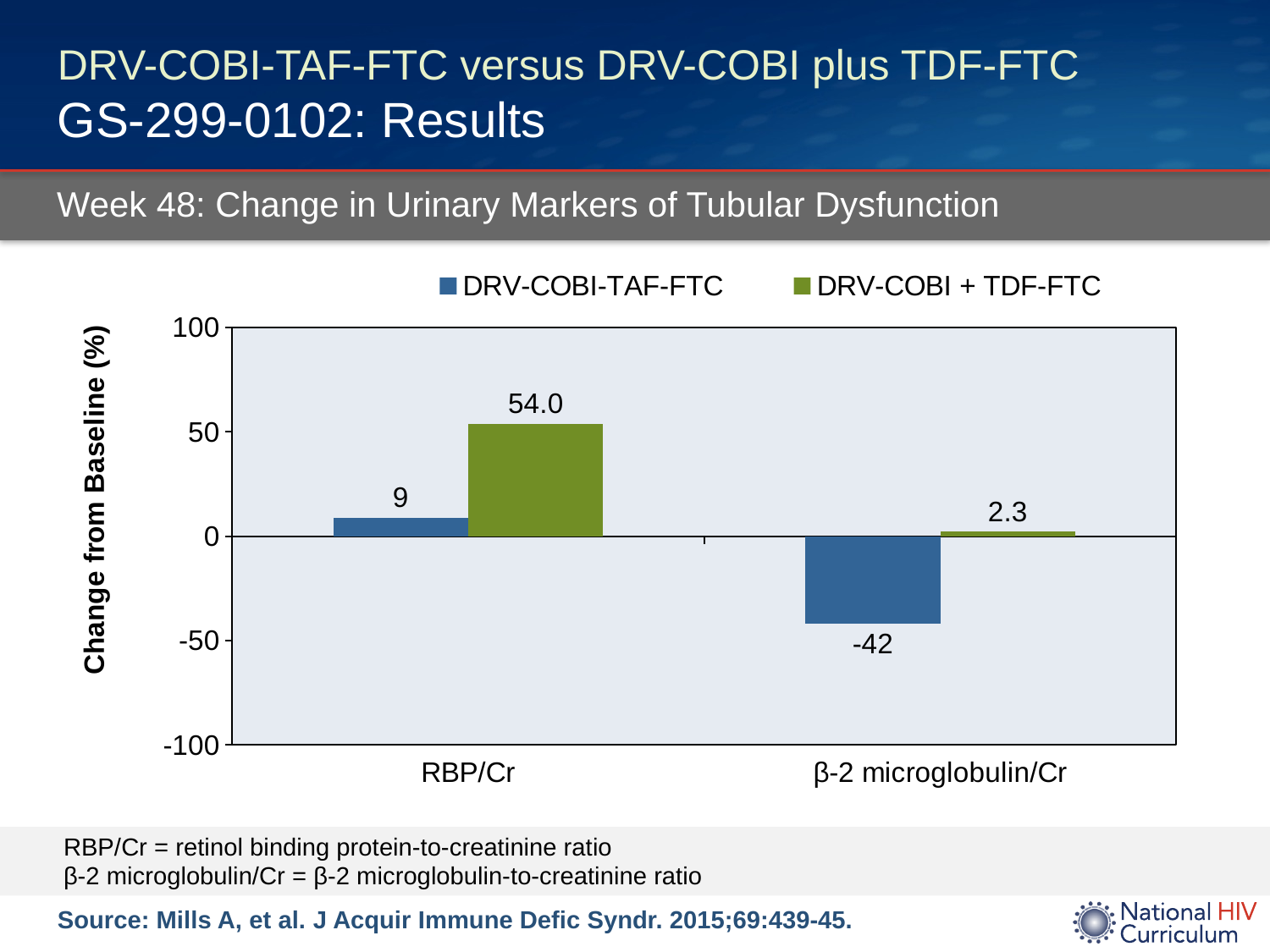
Is the DRV-COBI + TDF-FTC value for RBP/Cr greater or less than 50? greater What is the difference between the DRV-COBI + TDF-FTC and DRV-COBI-TAF-FTC values for RBP/Cr? 45 How many categories are shown on the x axis? 2 What kind of chart is shown on the slide? bar chart Which bar shows the highest change from baseline on the chart? DRV-COBI + TDF-FTC, RBP/Cr What is the change from baseline for DRV-COBI-TAF-FTC in β-2 microglobulin/Cr? -42 Which bar shows the lowest change from baseline on the chart? DRV-COBI-TAF-FTC, β-2 microglobulin/Cr For β-2 microglobulin/Cr, which series has the larger change from baseline? DRV-COBI + TDF-FTC What is the change from baseline for DRV-COBI + TDF-FTC in β-2 microglobulin/Cr? 2.3 How many series does the legend list? 2 What is the change from baseline for DRV-COBI + TDF-FTC in RBP/Cr? 54.0 What is the change from baseline for DRV-COBI-TAF-FTC in RBP/Cr? 9